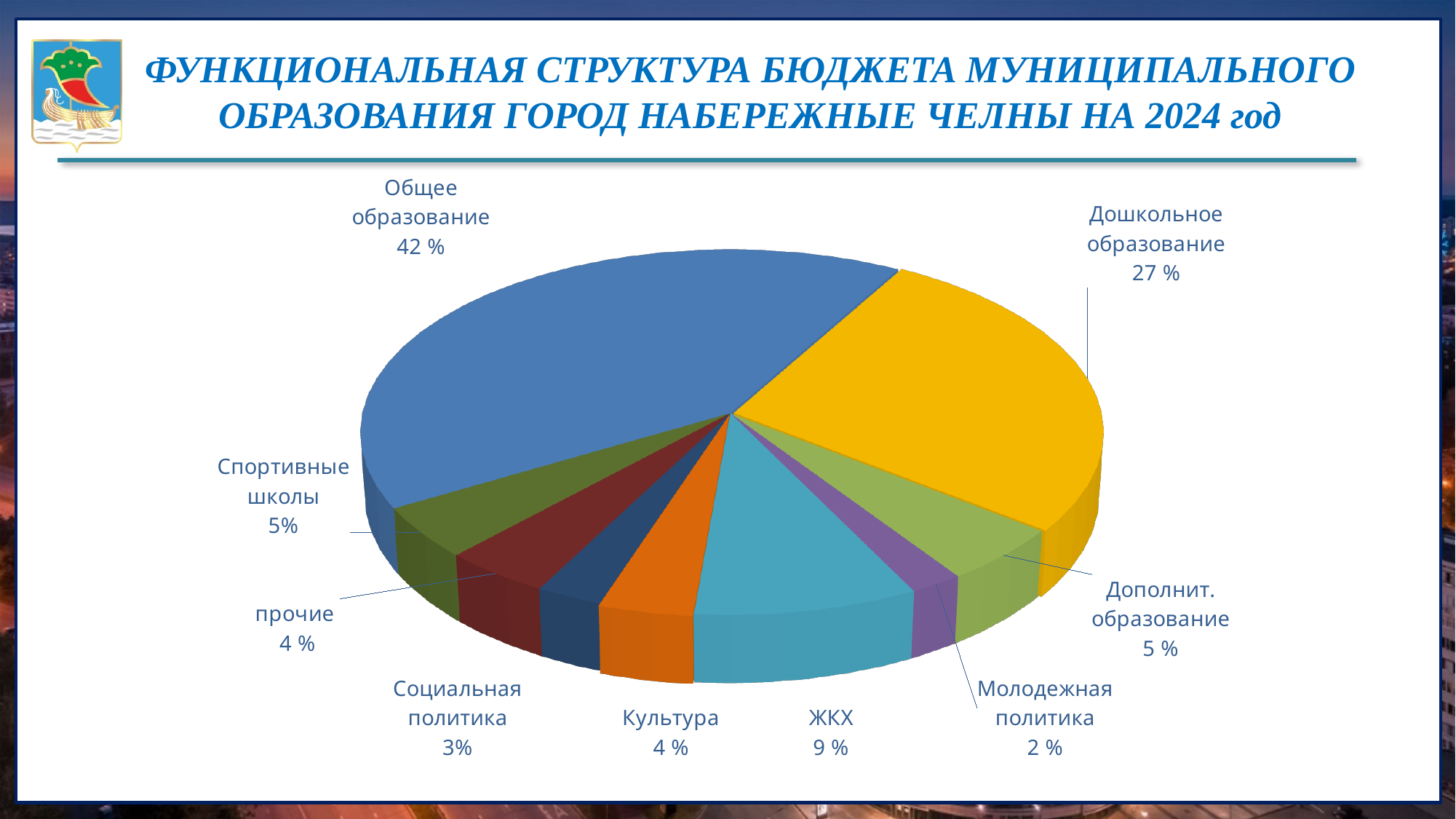
What type of chart is shown on the slide? pie chart Which category has the smallest share of the budget? Молодежная политика How many categories are shown in the pie chart? 9 What share of the budget goes to ЖКХ? 9 % What share of the budget goes to Общее образование? 42 % What share of the budget goes to Дошкольное образование? 27 % What share of the budget goes to Молодежная политика? 2 % Which is larger, the share for ЖКХ or the share for Культура? ЖКХ What colour is the slice for Дошкольное образование? yellow What share of the budget goes to Социальная политика? 3% What is the difference in percentage points between Общее образование and Дошкольное образование? 15 Which category has the largest share of the budget? Общее образование